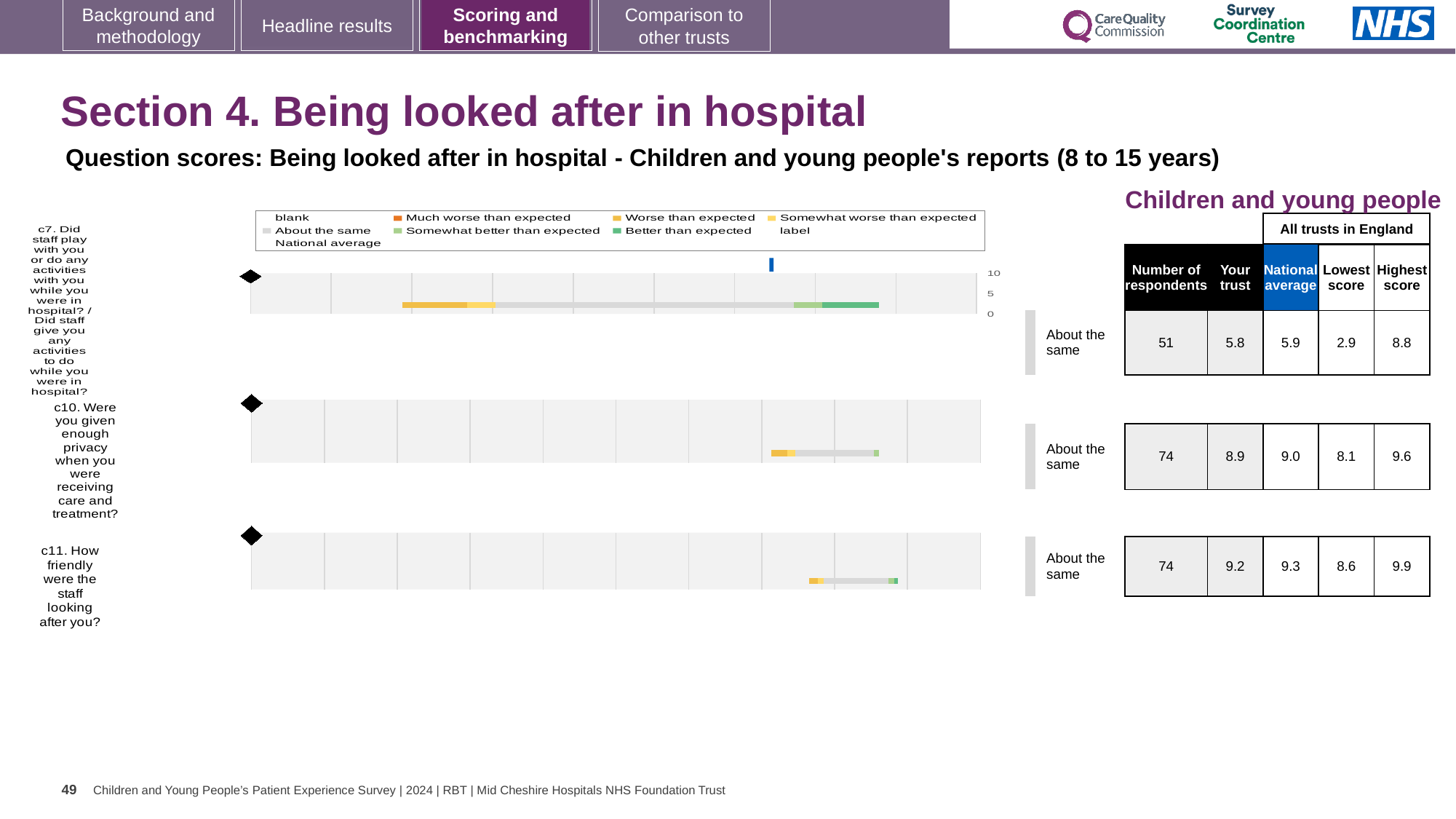
What is the lowest score across all trusts in England for question c10? 8.1 What kind of chart is used to show the question scores? bar chart How many respondents answered question c7 (Did staff play with you or do any activities with you while you were in hospital?)? 51 How many questions are plotted on the slide? 3 What is the national average score for question c10 (Were you given enough privacy when you were receiving care and treatment?)? 9.0 What is the 'Your trust' score for question c11 (How friendly were the staff looking after you?)? 9.2 Is the 'Your trust' score for c10 larger or smaller than the national average for c10? smaller Is the trust score for question c7 greater or less than 5 on the chart's axis? greater Which of the three questions has the highest 'Highest score' across all trusts in England? c11 Which of the three questions has the lowest 'Your trust' score? c7 What is the difference between the highest score and the lowest score for question c7? 5.9 What benchmark category is shown for question c11? About the same